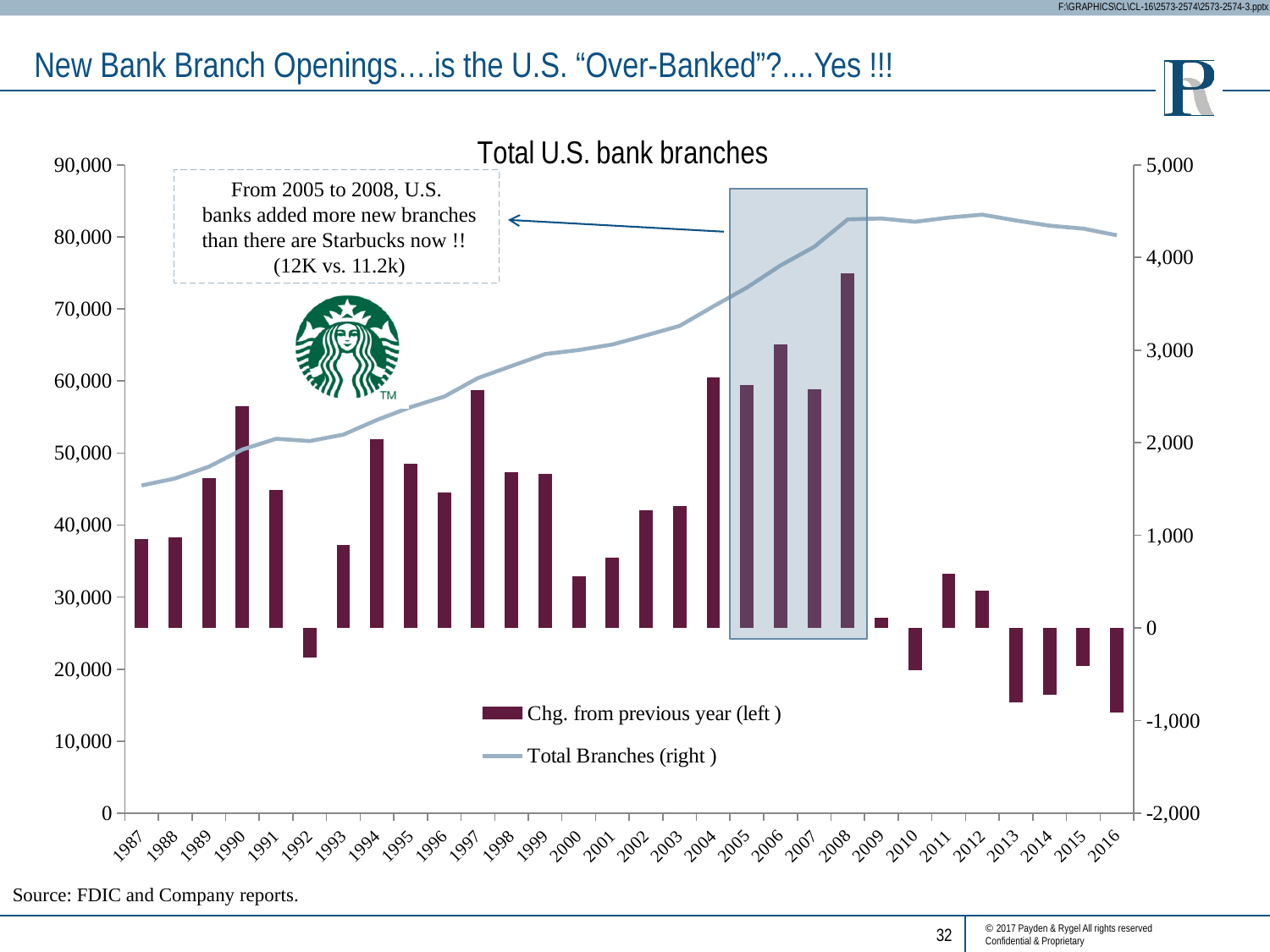
Which year has the larger 'Chg. from previous year' bar, 1989 or 1990? 1990 What is the title of the chart? Total U.S. bank branches What are the two series named in the legend? Chg. from previous year (left) and Total Branches (right) In which year is the 'Chg. from previous year' bar the highest? 2008 Does the 'Total Branches' line generally rise or fall from 1987 to 2008? Rise What kind of chart is shown on the slide? Combination bar and line chart Which year has the larger 'Chg. from previous year' bar, 2005 or 2006? 2006 How many years are shown along the x axis? 30 How many years show a negative 'Chg. from previous year' bar? 6 How many series does the chart legend list? 2 In which year is the 'Chg. from previous year' bar the lowest (most negative)? 2016 Does the 'Total Branches' line rise or fall from 2012 to 2016? Fall